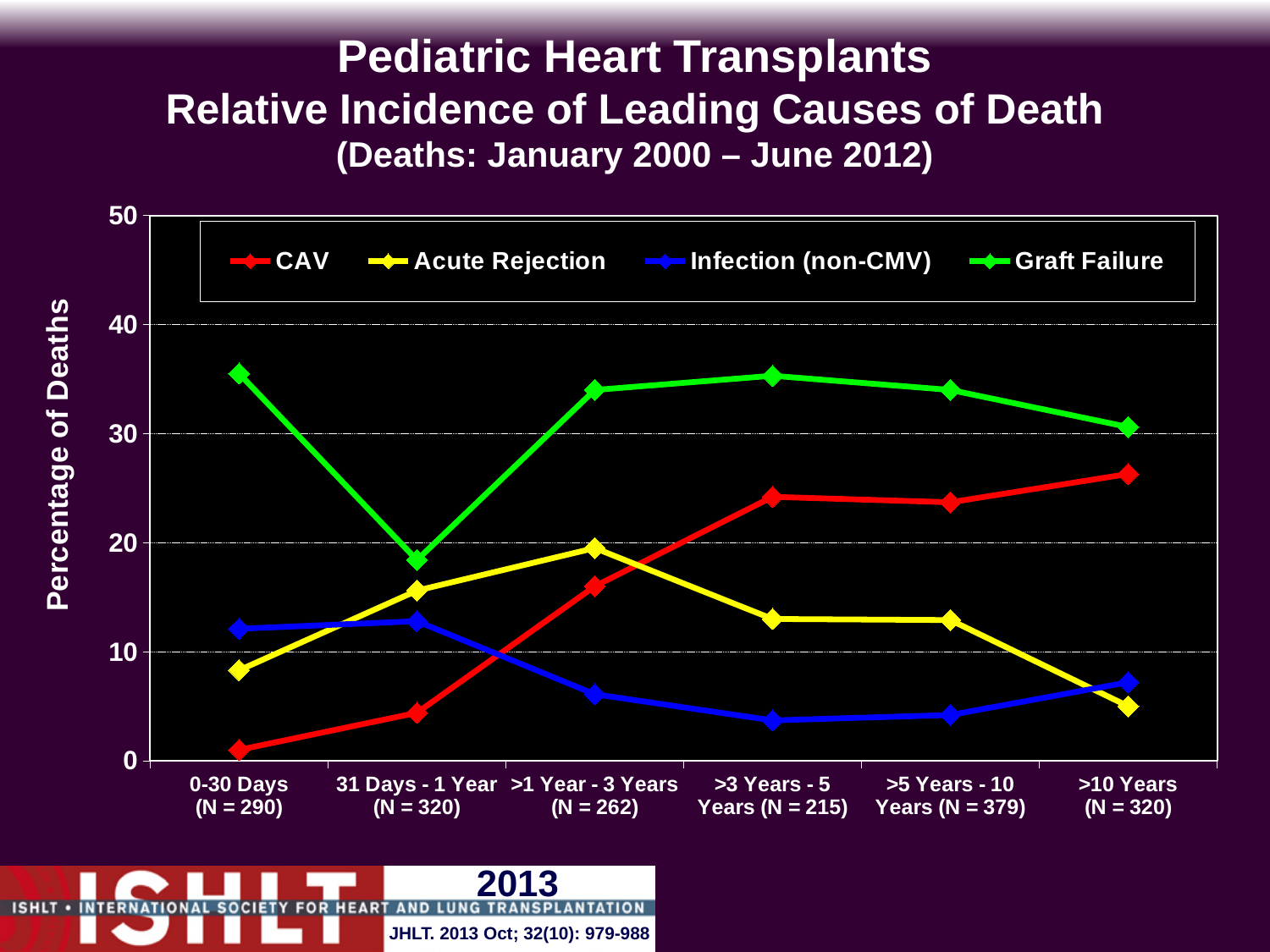
Is the value for Acute Rejection at >1 Year - 3 Years greater or less than 10? greater What colour is the Graft Failure line in the legend? green Which cause of death has the highest percentage at >10 Years? Graft Failure Is the value for CAV at 0-30 Days greater or less than 10? less How many series does the legend list? 4 At >3 Years - 5 Years, which is larger: CAV or Acute Rejection? CAV How many time-period categories are shown on the x axis? 6 Is the value for Infection (non-CMV) at >3 Years - 5 Years greater or less than 10? less Does the CAV line generally rise or fall from 0-30 Days to >10 Years? rise Which cause of death has the lowest percentage at 0-30 Days? CAV What kind of chart is shown on the slide? line chart